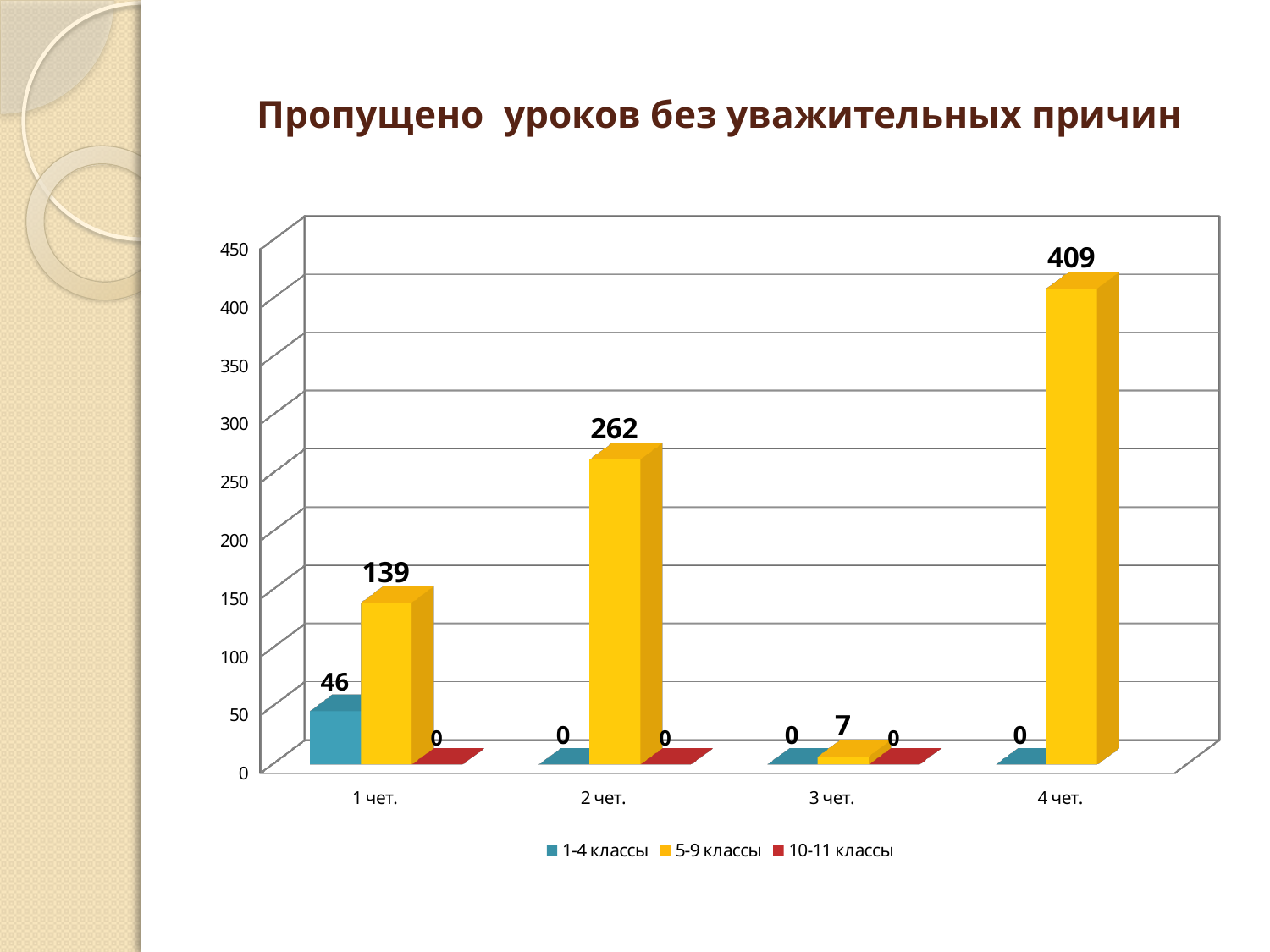
What kind of chart is shown on the slide? Bar chart In which quarter is the value for 5-9 классы highest? 4 чет. What is the value for 5-9 классы in 4 чет.? 409 What is the value for 1-4 классы in 1 чет.? 46 What is the title of the chart? Пропущено уроков без уважительных причин What is the value for 5-9 классы in 3 чет.? 7 In which quarter is the value for 5-9 классы lowest? 3 чет. What is the difference between the 5-9 классы values in 4 чет. and 2 чет.? 147 How many quarters (categories) are shown on the x axis? 4 How many series does the legend list? 3 Which is larger: the 5-9 классы value in 1 чет. or the 1-4 классы value in 1 чет.? 5-9 классы What is the value for 10-11 классы in 2 чет.? 0